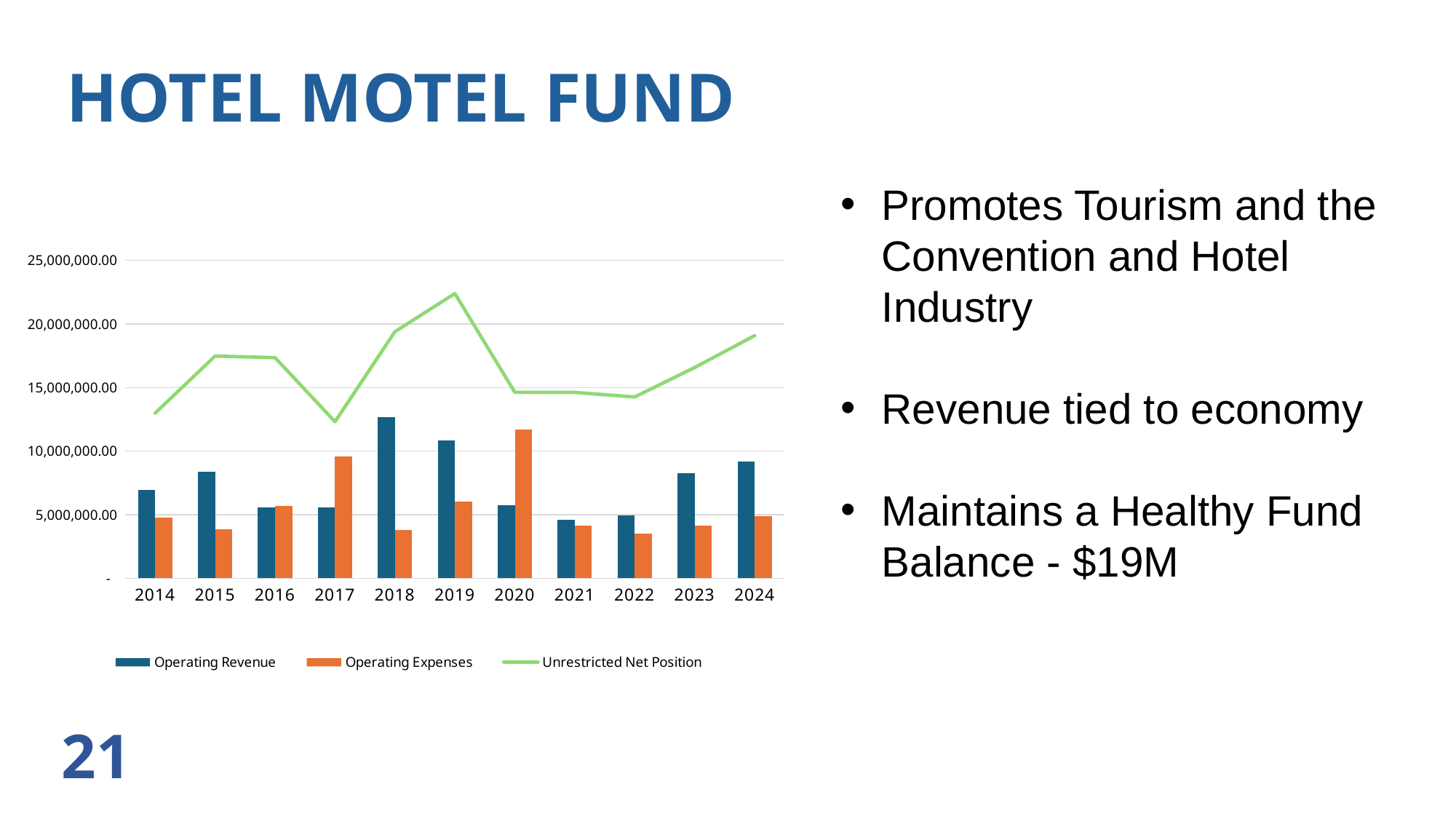
How many series does the chart legend list? 3 Is the Operating Revenue for 2018 greater or less than 10,000,000.00? greater In 2017, which is larger: Operating Revenue or Operating Expenses? Operating Expenses How many years are shown on the x axis of the chart? 11 What kind of chart is shown on the slide? Combined bar and line chart Does the Unrestricted Net Position rise or fall from 2022 to 2024? rise In which year is Operating Revenue highest? 2018 Which series is drawn as a green line in the chart? Unrestricted Net Position Is the Operating Revenue for 2021 greater or less than 5,000,000.00? less Is the Unrestricted Net Position for 2019 greater or less than 20,000,000.00? greater In which year is Operating Expenses highest? 2020 In which year is Unrestricted Net Position highest? 2019